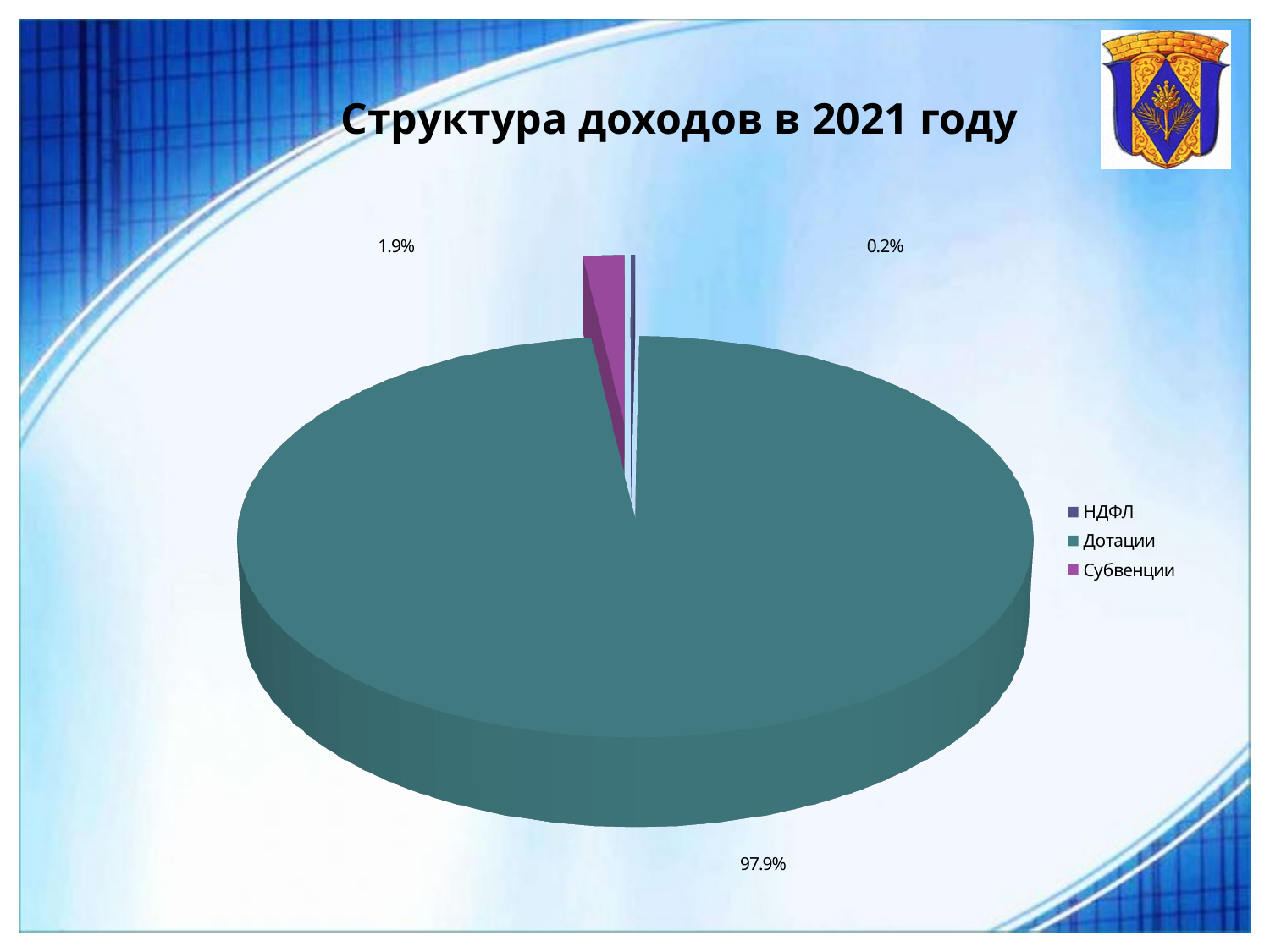
Which is larger, the share for Субвенции or the share for НДФЛ? Субвенции What share of the pie does Субвенции have? 1.9% How many entries does the legend list? 3 What kind of chart is shown on the slide? pie chart Which category has the smallest share of the pie? НДФЛ Which legend entry is shown in purple? Субвенции How many slices does the pie chart have? 3 What share of the pie does НДФЛ have? 0.2% Which category has the largest share of the pie? Дотации What is the title of the chart? Структура доходов в 2021 году What is the difference between the share for Субвенции and the share for НДФЛ? 1.7% What share of the pie does Дотации have? 97.9%